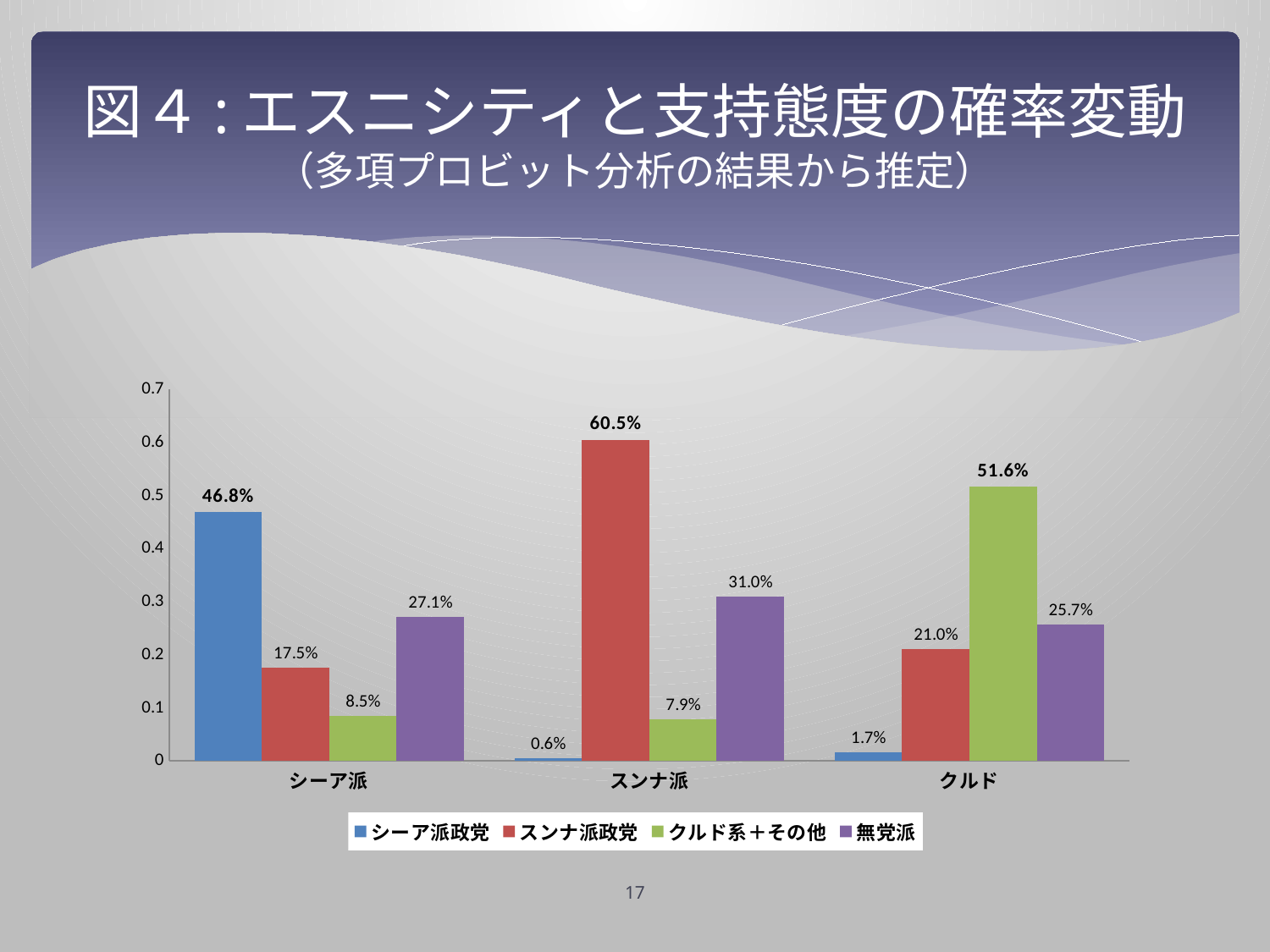
How many ethnic groups are shown on the x axis? 3 How many series does the legend list? 4 What is the value for スンナ派政党 in the スンナ派 group? 60.5% What is the value for 無党派 in the スンナ派 group? 31.0% What is the value for シーア派政党 in the シーア派 group? 46.8% Which is larger: 無党派 in the シーア派 group or 無党派 in the クルド group? シーア派 group (27.1%) Which series has the highest value in the シーア派 group? シーア派政党 What kind of chart is shown on the slide? Bar chart What colour represents スンナ派政党 in the chart? Red What is the difference between スンナ派政党 and 無党派 in the スンナ派 group? 29.5% Which series has the lowest value in the スンナ派 group? シーア派政党 What is the value for クルド系＋その他 in the クルド group? 51.6%